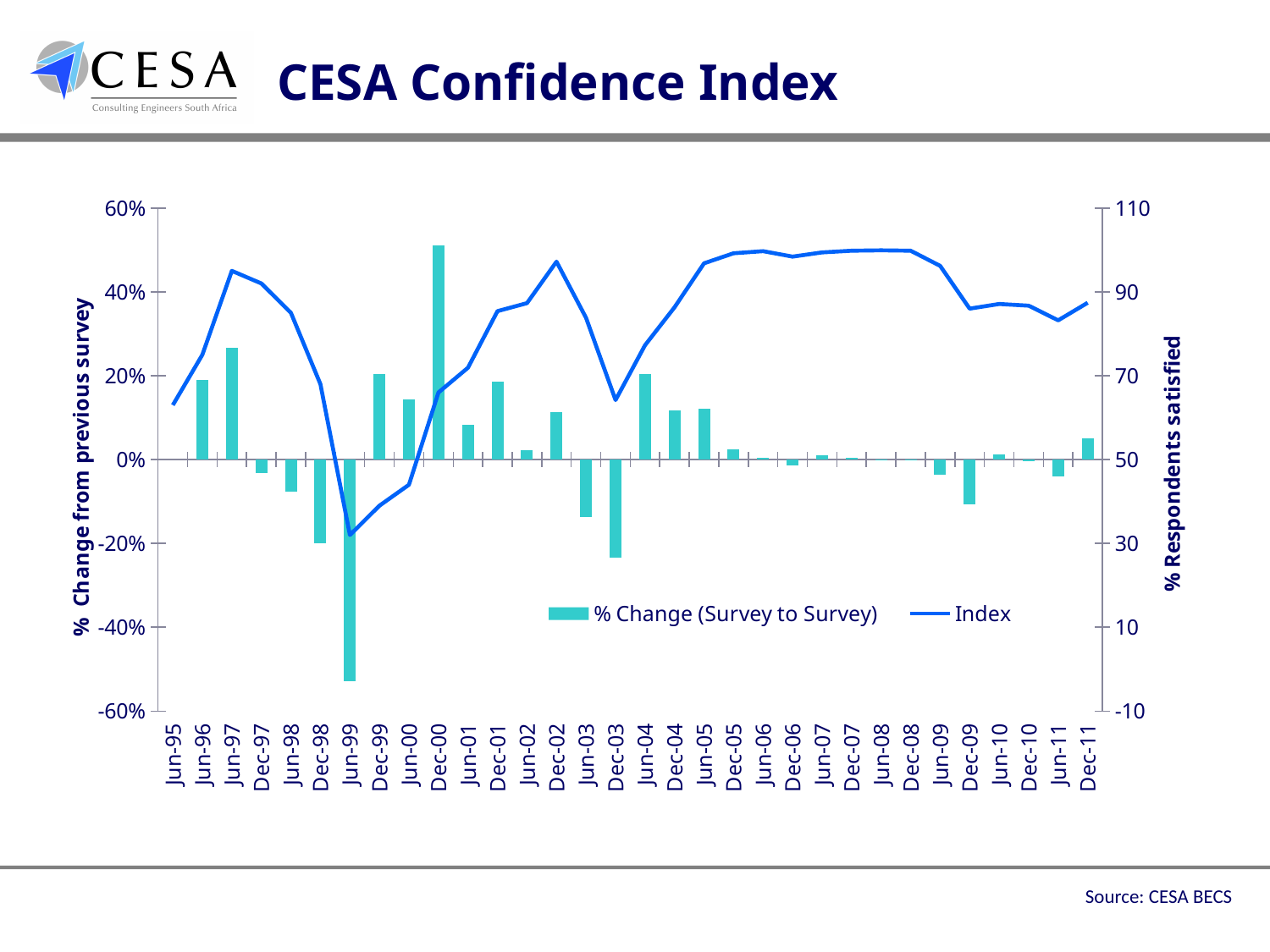
Which is larger, the % Change (Survey to Survey) bar for Jun-96 or for Jun-97? Jun-97 How many series does the legend list? 2 Which survey date has the highest % Change (Survey to Survey) bar? Dec-00 Is the Index value for Jun-99 greater or less than 50? less Is the % Change (Survey to Survey) value for Jun-99 greater or less than -40%? less Does the Index line rise or fall between Jun-97 and Jun-99? It falls Which survey date has the lowest % Change (Survey to Survey) bar? Jun-99 What is the title of the right-hand vertical axis? % Respondents satisfied Is the % Change (Survey to Survey) value for Dec-00 greater or less than 40%? greater What kind of chart is shown on the slide? A combination bar and line chart How many survey dates are labelled on the x axis? 32